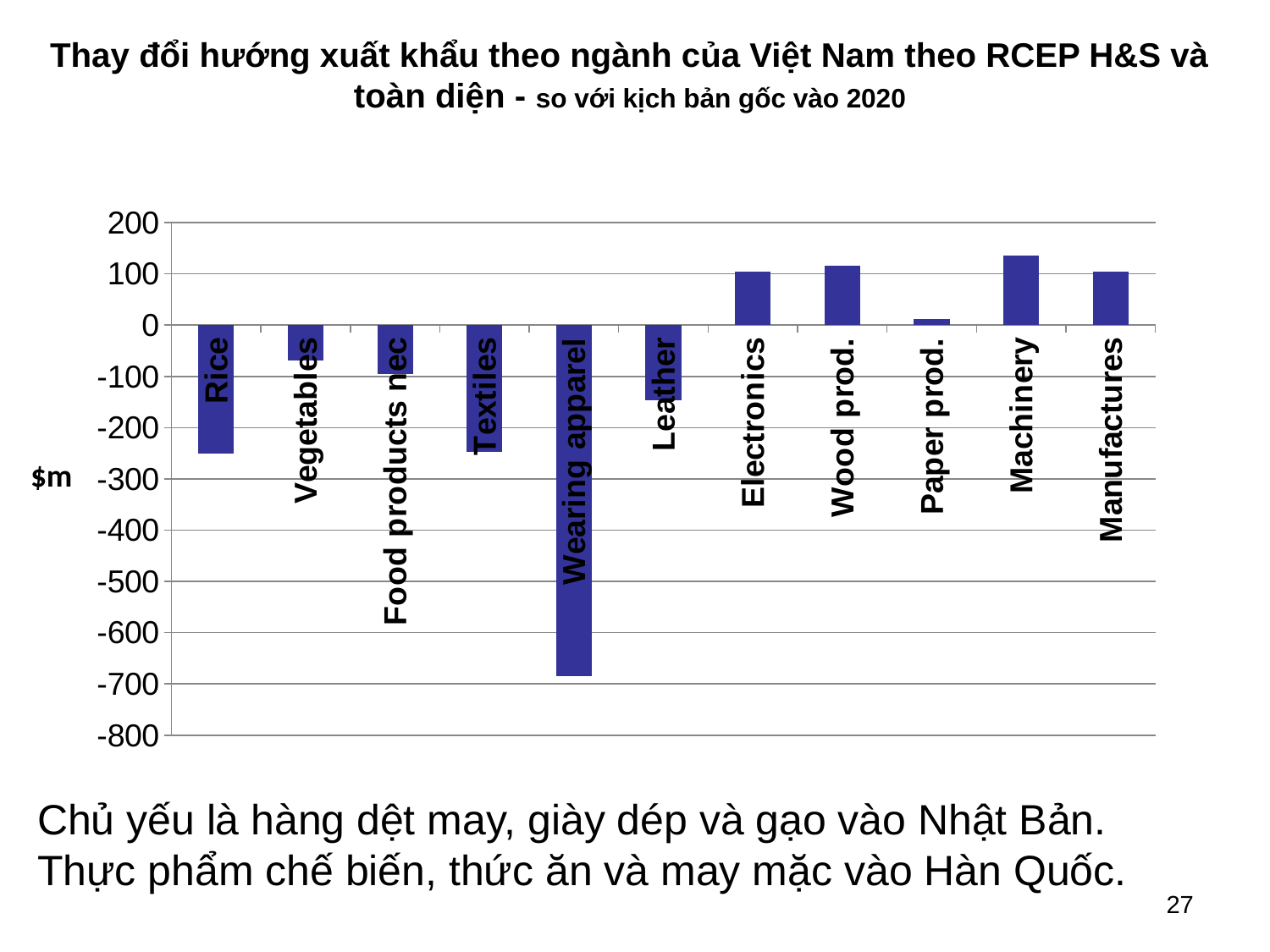
What kind of chart is shown on the slide? bar chart Is the value for Rice greater or less than -200? less What unit label is shown on the vertical axis of the chart? $m Which sector has the lowest (most negative) value on the chart? Wearing apparel Is the value for Wearing apparel greater or less than -600? less How many sectors have negative values on the chart? 6 Is the value for Machinery greater or less than 100? greater How many categories (sectors) are plotted on the chart? 11 Which sector has the highest value on the chart? Machinery Which has the larger value, Electronics or Wearing apparel? Electronics